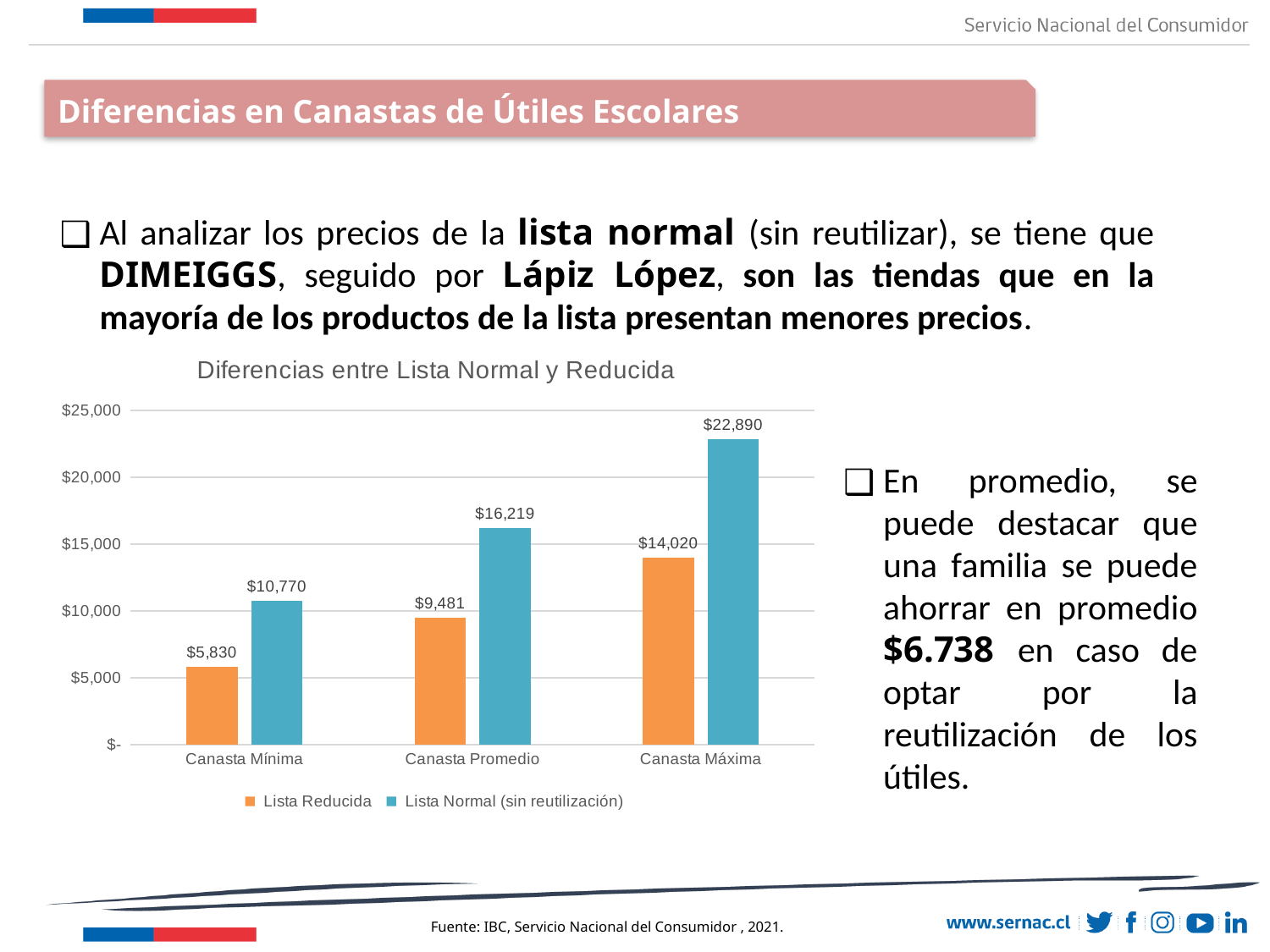
What is the value of Lista Normal (sin reutilización) for Canasta Promedio? $16,219 How many series does the legend list? 2 What type of chart is shown? Bar chart How many categories are shown on the x axis? 3 Which category has the highest Lista Normal (sin reutilización) value? Canasta Máxima What is the value of Lista Normal (sin reutilización) for Canasta Máxima? $22,890 What is the difference between Lista Normal (sin reutilización) and Lista Reducida for Canasta Promedio? $6,738 What is the value of Lista Reducida for Canasta Máxima? $14,020 Which is larger for Canasta Mínima: Lista Reducida or Lista Normal (sin reutilización)? Lista Normal (sin reutilización) Is the Lista Normal (sin reutilización) value for Canasta Mínima greater or less than $10,000? greater What is the value of Lista Reducida for Canasta Mínima? $5,830 Which category has the lowest Lista Reducida value? Canasta Mínima